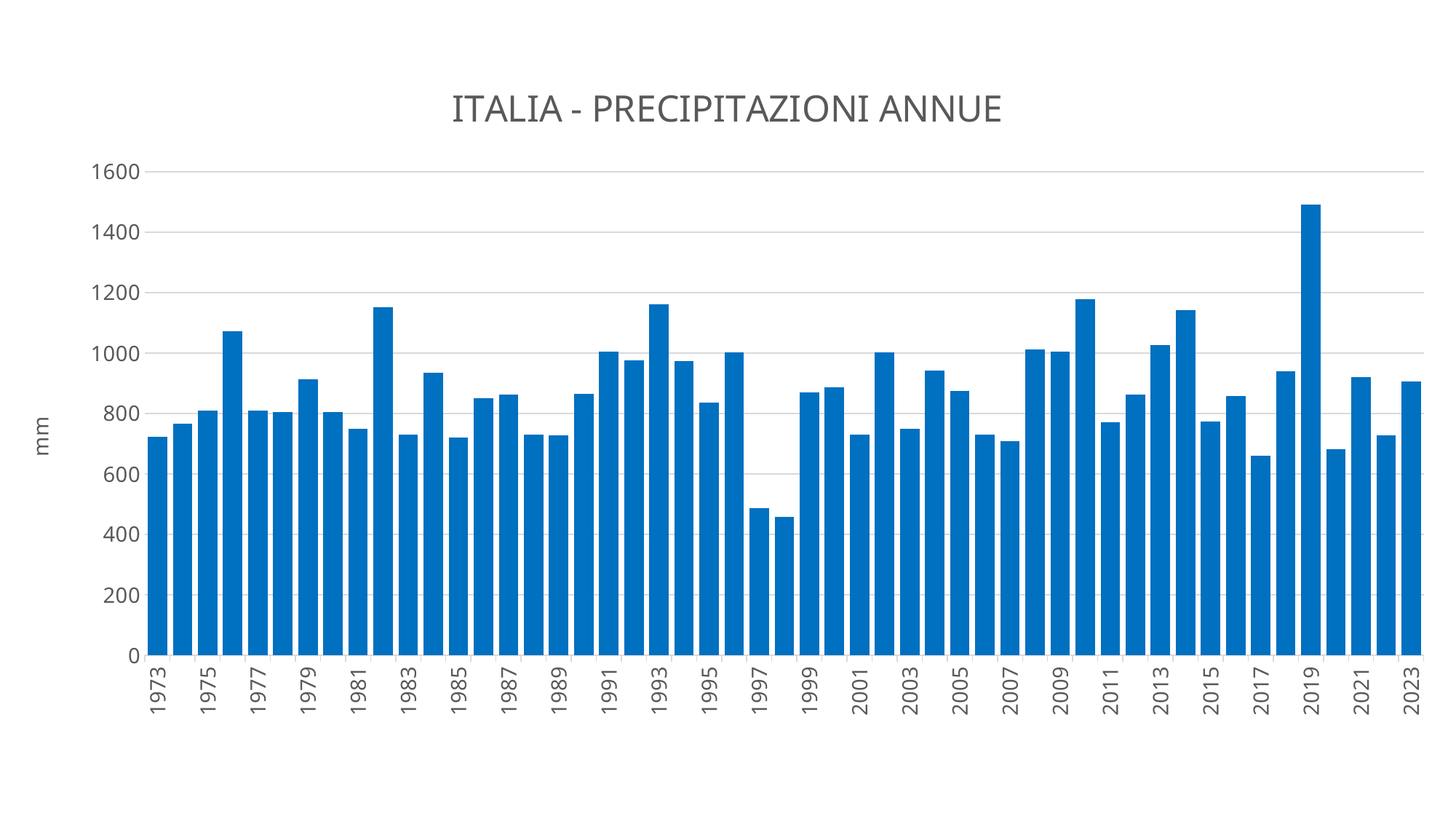
How many years (bars) are plotted on the chart? 51 What is the title of the chart? ITALIA - PRECIPITAZIONI ANNUE Is the value for 1993 greater or less than 1000? greater Is the value for 1997 greater or less than 600? less Which is larger, the value for 2019 or the value for 2010? 2019 Which is larger, the value for 1996 or the value for 1997? 1996 What kind of chart is shown on the slide? bar chart Which year has the highest bar? 2019 What unit is shown on the vertical axis label? mm Is the value for 1982 greater or less than 1000? greater